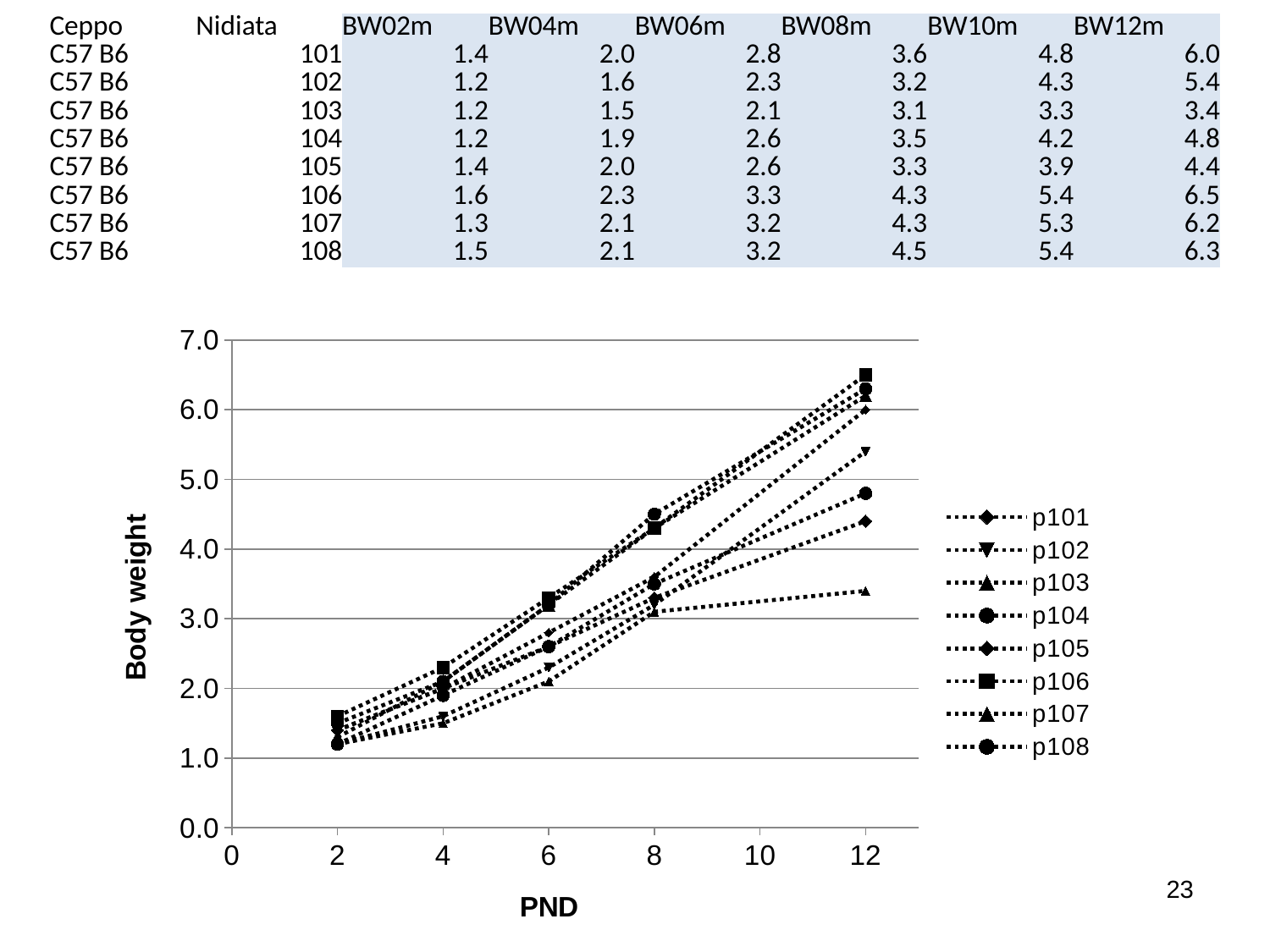
What is the label of the y axis of the chart? Body weight What is the body weight of p103 at PND 12? 3.4 What is the body weight of p106 at PND 12? 6.5 How many series does the chart legend list? 8 Which series has the highest body weight at PND 12? p106 Is the body weight of p103 at PND 12 greater or less than 4.0? less What is the difference in body weight between p106 and p103 at PND 12? 3.1 Do the body weight values rise or fall as PND increases? rise What is the label of the x axis of the chart? PND What kind of chart is shown on the slide? line chart Which series has the larger body weight at PND 12, p102 or p104? p102 Which series has the lowest body weight at PND 12? p103